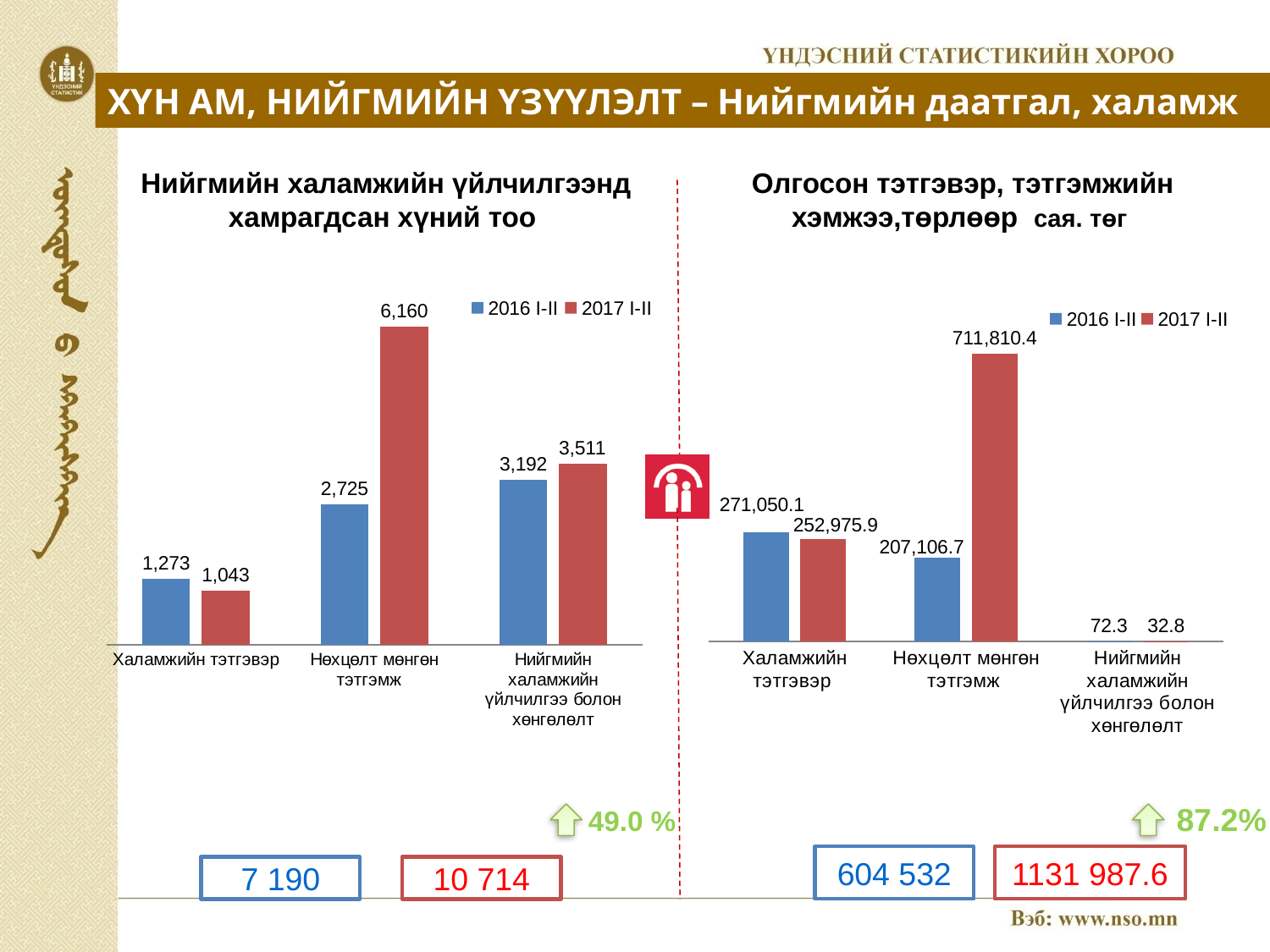
In the right chart (Олгосон тэтгэвэр, тэтгэмжийн хэмжээ), what is the 2017 I-II value for Нөхцөлт мөнгөн тэтгэмж? 711,810.4 In the left chart, what is the 2016 I-II value for Халамжийн тэтгэвэр? 1,273 In the left chart, for Халамжийн тэтгэвэр, which is larger: the 2016 I-II value or the 2017 I-II value? 2016 I-II In the left chart, which category has the lowest 2016 I-II value? Халамжийн тэтгэвэр In the left chart, which category has the highest 2017 I-II value? Нөхцөлт мөнгөн тэтгэмж How many series does the legend of the right chart list? 2 In the right chart, what is the difference between the 2016 I-II and 2017 I-II values for Халамжийн тэтгэвэр? 18,074.2 What type of chart is the left chart? Bar chart In the left chart (Нийгмийн халамжийн үйлчилгээнд хамрагдсан хүний тоо), what is the 2017 I-II value for Нөхцөлт мөнгөн тэтгэмж? 6,160 In the right chart, what is the 2016 I-II value for Нийгмийн халамжийн үйлчилгээ болон хөнгөлөлт? 72.3 In the right chart, which category has the lowest 2017 I-II value? Нийгмийн халамжийн үйлчилгээ болон хөнгөлөлт In the left chart, what is the difference between the 2017 I-II and 2016 I-II values for Нөхцөлт мөнгөн тэтгэмж? 3,435